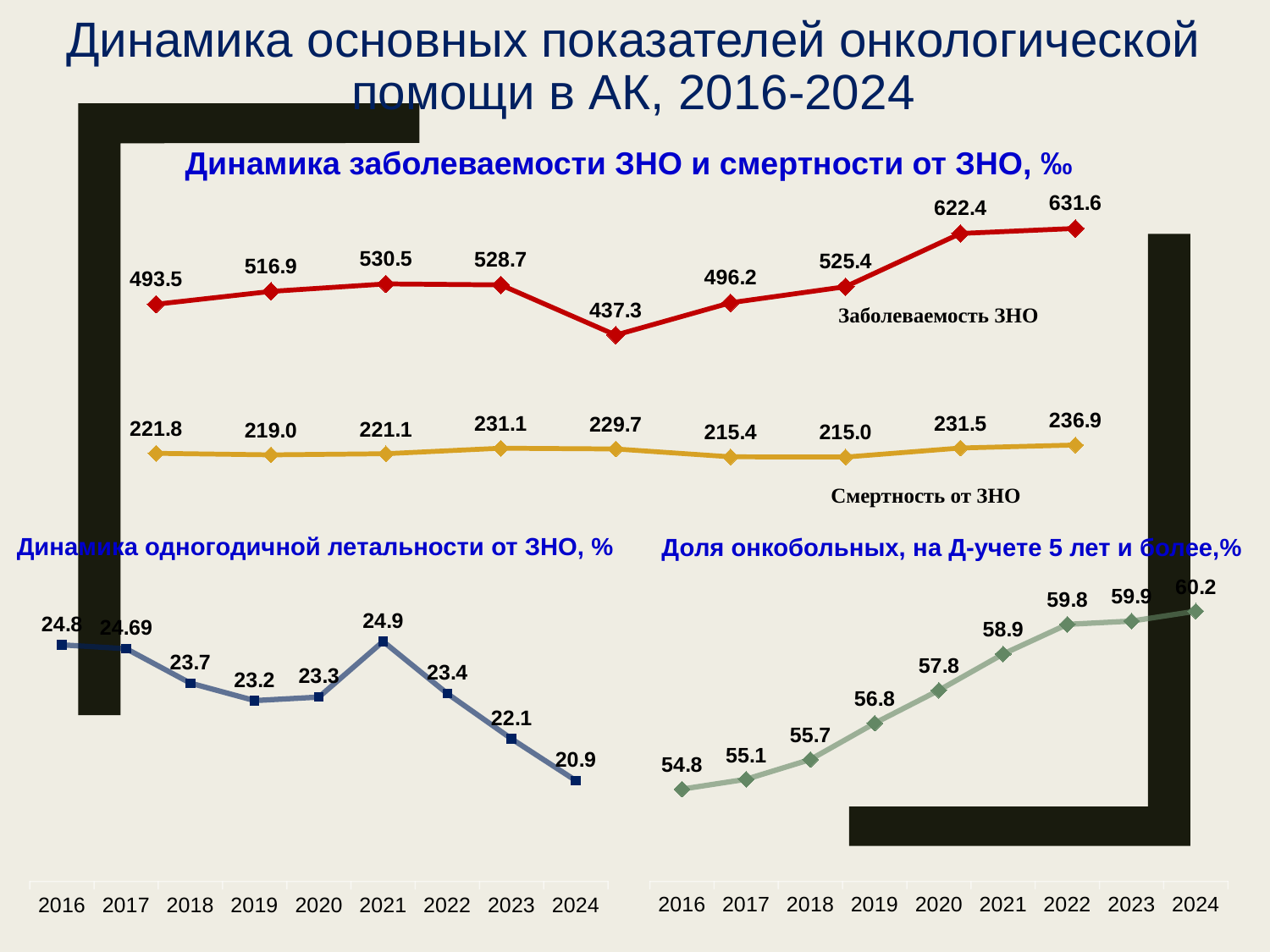
In the chart 'Доля онкобольных, на Д-учете 5 лет и более,%', what is the value for 2019? 56.8 In the chart 'Доля онкобольных, на Д-учете 5 лет и более,%', what is the difference between the 2024 and 2016 values? 5.4 In the chart 'Динамика заболеваемости ЗНО и смертности от ЗНО, ‰', what is the lowest value of the 'Заболеваемость ЗНО' series? 437.3 In the chart 'Доля онкобольных, на Д-учете 5 лет и более,%', do the values rise or fall from 2016 to 2024? rise In the chart 'Динамика заболеваемости ЗНО и смертности от ЗНО, ‰', what is the highest value of the 'Заболеваемость ЗНО' series? 631.6 In the chart 'Динамика заболеваемости ЗНО и смертности от ЗНО, ‰', what is the lowest value of the 'Смертность от ЗНО' series? 215.0 In the chart 'Динамика одногодичной летальности от ЗНО, %', which is larger: the value for 2018 or the value for 2022? 2018 In the chart 'Динамика одногодичной летальности от ЗНО, %', what is the difference between the 2023 and 2024 values? 1.2 How many series are plotted in the chart 'Динамика заболеваемости ЗНО и смертности от ЗНО, ‰'? 2 How many data points does the chart 'Доля онкобольных, на Д-учете 5 лет и более,%' have? 9 In the chart 'Динамика одногодичной летальности от ЗНО, %', which year has the lowest value? 2024 In the chart 'Динамика одногодичной летальности от ЗНО, %', what is the value for 2021? 24.9